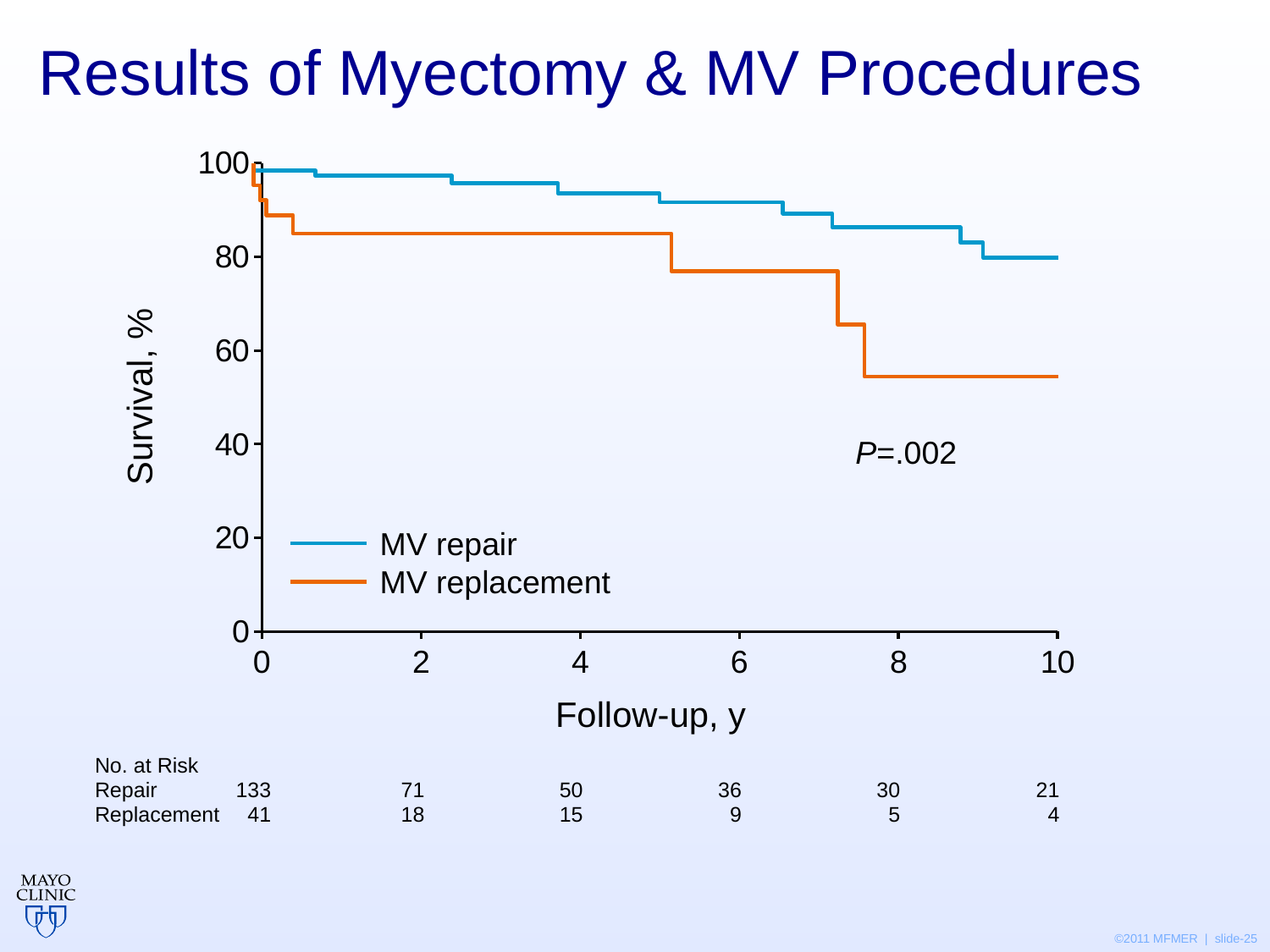
Is the survival for MV replacement at 10 years of follow-up greater or less than 60? less According to the No. at Risk table, how many Repair patients were at risk at 0 years? 133 What are the two series named in the legend? MV repair and MV replacement Is the survival for MV repair at 10 years of follow-up greater or less than 60? greater What kind of chart is shown on the slide? line chart According to the No. at Risk table, how many more Repair patients than Replacement patients were at risk at 0 years? 92 Which series shows higher survival at 10 years of follow-up, MV repair or MV replacement? MV repair Do the survival curves rise or fall as follow-up time increases? fall How many series does the legend list? 2 According to the No. at Risk table, how many Replacement patients were at risk at 10 years? 4 What P value is printed on the chart? P=.002 Is the survival for MV replacement at 4 years of follow-up greater or less than 80? greater